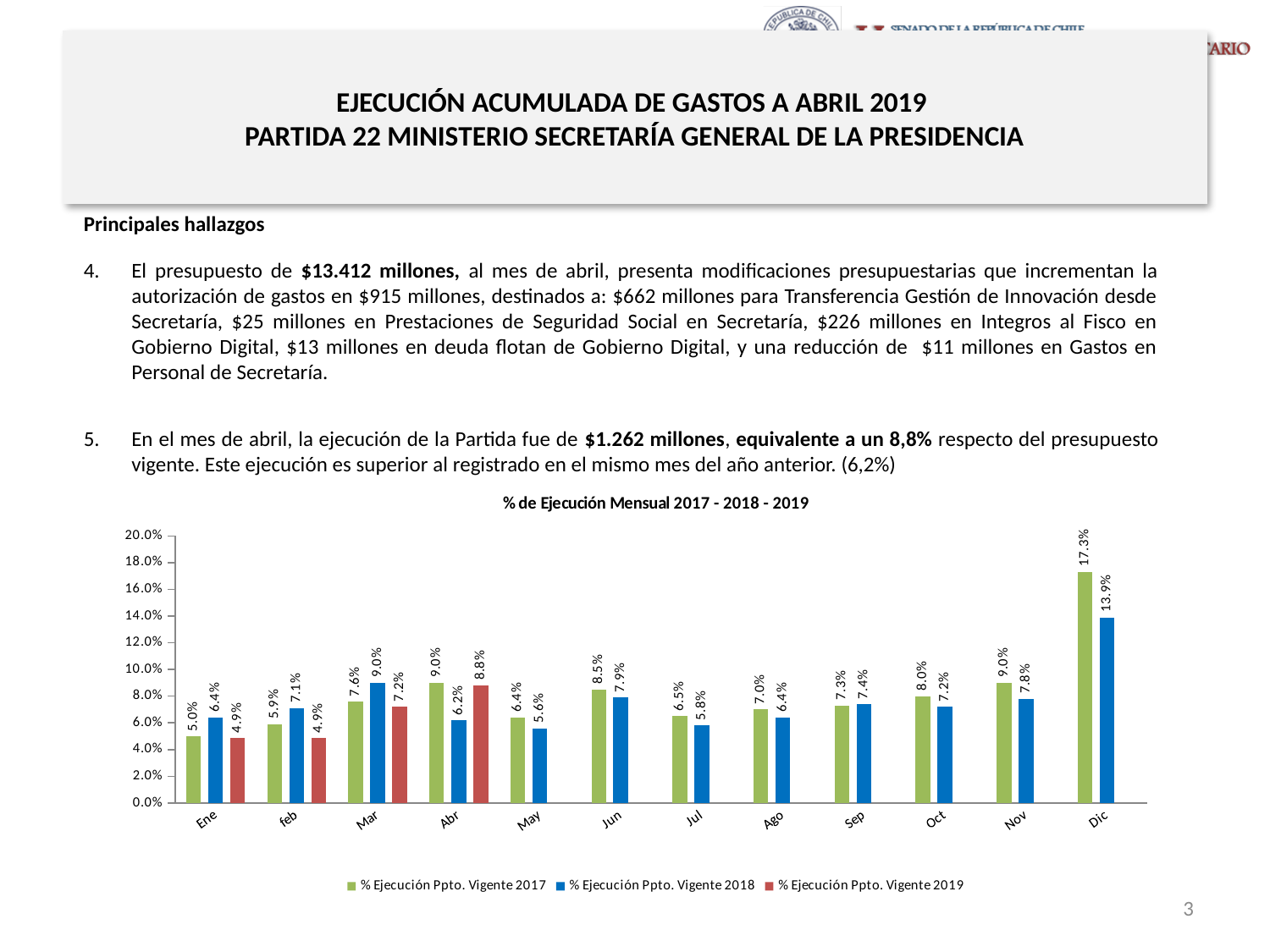
In Abr, which is larger: the 2017 value or the 2018 value? 2017 What is the difference between the 2017 and 2018 values in Dic? 3.4% What is the value for % Ejecución Ppto. Vigente 2018 in Mar? 9.0% Is the value for % Ejecución Ppto. Vigente 2018 in Dic greater or less than 12.0%? greater How many series does the legend list? 3 What is the value for % Ejecución Ppto. Vigente 2019 in Abr? 8.8% What kind of chart is shown on the slide? Bar chart How many months are shown on the x axis? 12 What is the title of the chart? % de Ejecución Mensual 2017 - 2018 - 2019 What is the value for % Ejecución Ppto. Vigente 2017 in Dic? 17.3% Which month has the lowest value for % Ejecución Ppto. Vigente 2017? Ene Which month has the highest value for % Ejecución Ppto. Vigente 2018? Dic